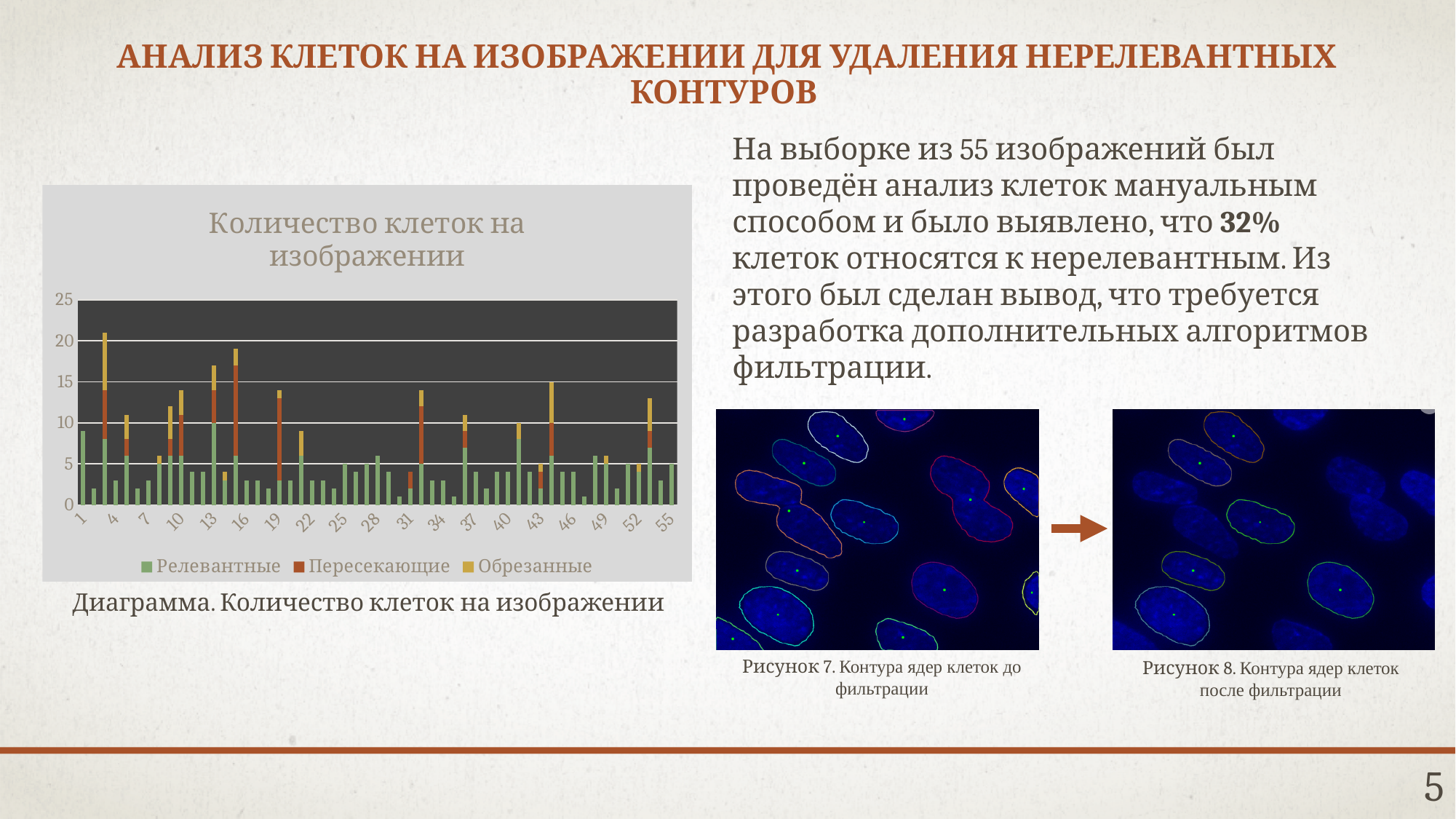
Is the total value of the stacked bar for image 3 greater or less than 20? greater Is the total value of the stacked bar for image 53 greater or less than 10? greater How many series does the legend of the chart list? 3 Which image number has the tallest stacked bar in the chart? 3 Is the total value of the stacked bar for image 15 greater or less than 15? greater What kind of chart is shown on the slide? bar chart Which stacked bar is taller in the chart, the one for image 3 or the one for image 1? image 3 What is the title of the chart? Количество клеток на изображении How many images (categories) are plotted along the x axis of the chart? 55 Which series in the chart is shown in green? Релевантные